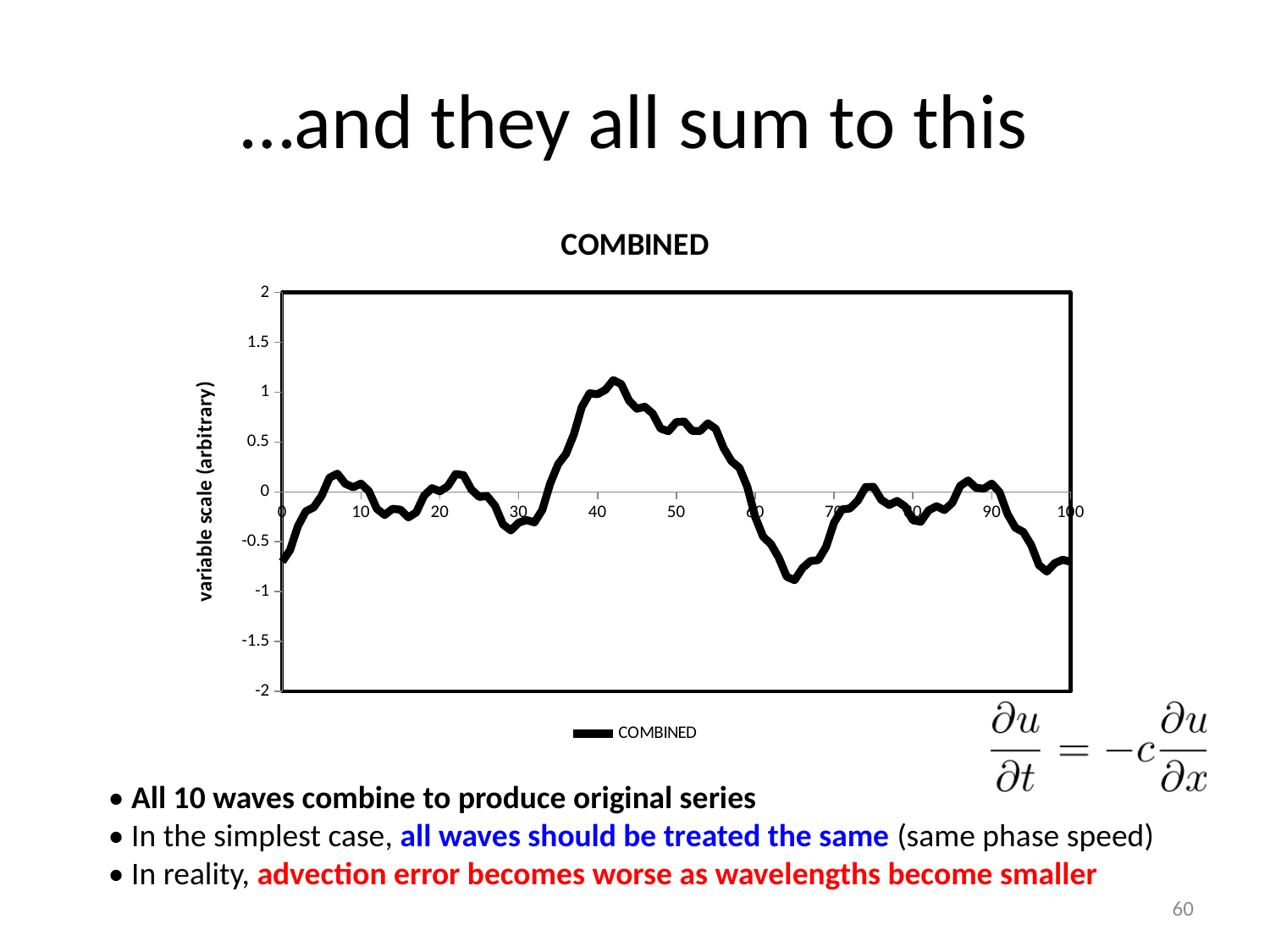
Does the COMBINED series rise or fall between x = 55 and x = 65? fall Is the value of the COMBINED series at x = 50 greater or less than 0? greater How many series does the chart's legend list? 1 Which is larger, the value of the COMBINED series at x = 40 or at x = 65? x = 40 Is the value of the COMBINED series at x = 40 greater or less than 0.5? greater Is the highest value reached by the COMBINED series greater or less than 0.5? greater What type of chart is shown on the slide? line chart Does the COMBINED series rise or fall between x = 30 and x = 40? rise What is the label on the vertical axis of the chart? variable scale (arbitrary) What is the title of the chart? COMBINED